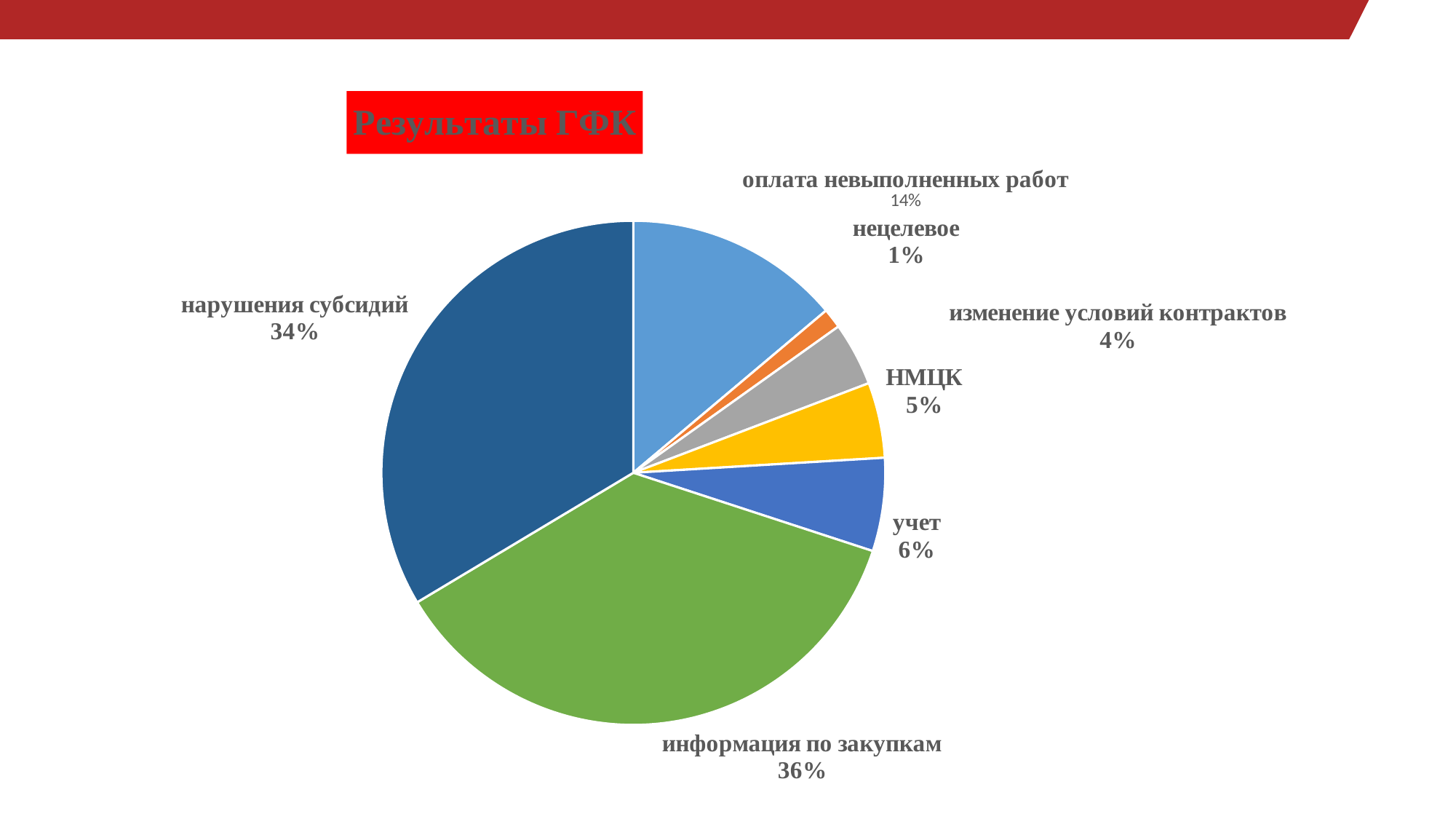
What is the share for "оплата невыполненных работ"? 14% How many slices does the pie chart have? 7 Which category has the smallest slice of the pie? нецелевое What is the title of the chart? Результаты ГФК What is the share for "НМЦК"? 5% Which category has the largest slice of the pie? информация по закупкам Which is larger, the share for "учет" or the share for "изменение условий контрактов"? учет What is the share for "нарушения субсидий"? 34% What is the share for "учет"? 6% What kind of chart is shown on the slide? pie chart What is the difference in percentage points between "информация по закупкам" and "нарушения субсидий"? 2% What is the share for "информация по закупкам"? 36%